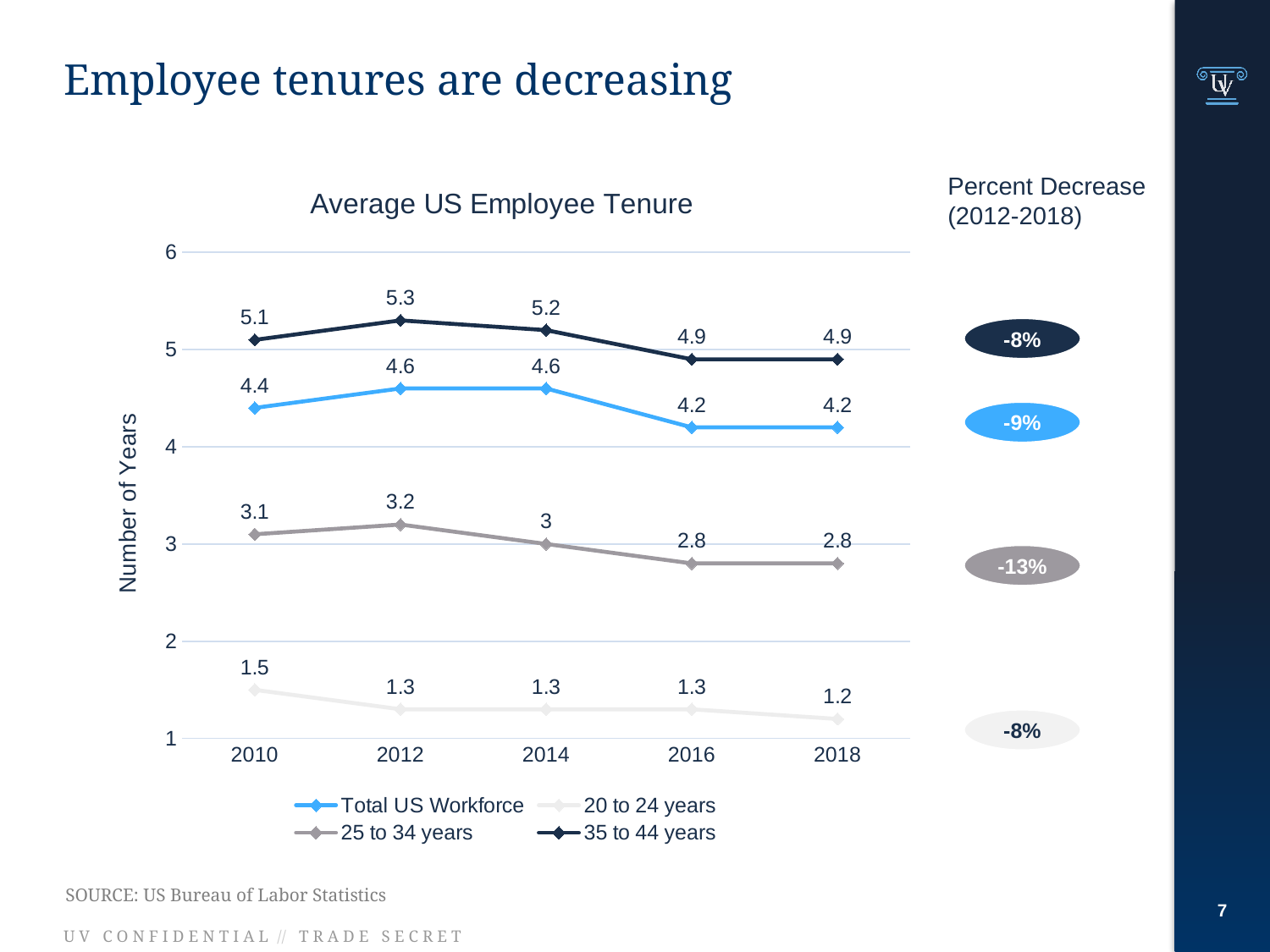
How many series does the legend list? 4 What is the Total US Workforce average tenure in 2018? 4.2 What is the average tenure for the 20 to 24 years group in 2010? 1.5 How many years are shown on the x axis? 5 What is the title of the chart? Average US Employee Tenure What is the difference between the 35 to 44 years tenure in 2012 and in 2018? 0.4 What is the average tenure for the 35 to 44 years group in 2012? 5.3 In which year is the 25 to 34 years series at its highest? 2012 Does the Total US Workforce tenure rise or fall from 2012 to 2018? Fall What kind of chart is shown? Line chart Which is larger in 2014: the Total US Workforce tenure or the 25 to 34 years tenure? Total US Workforce In which year is the 20 to 24 years series at its lowest? 2018